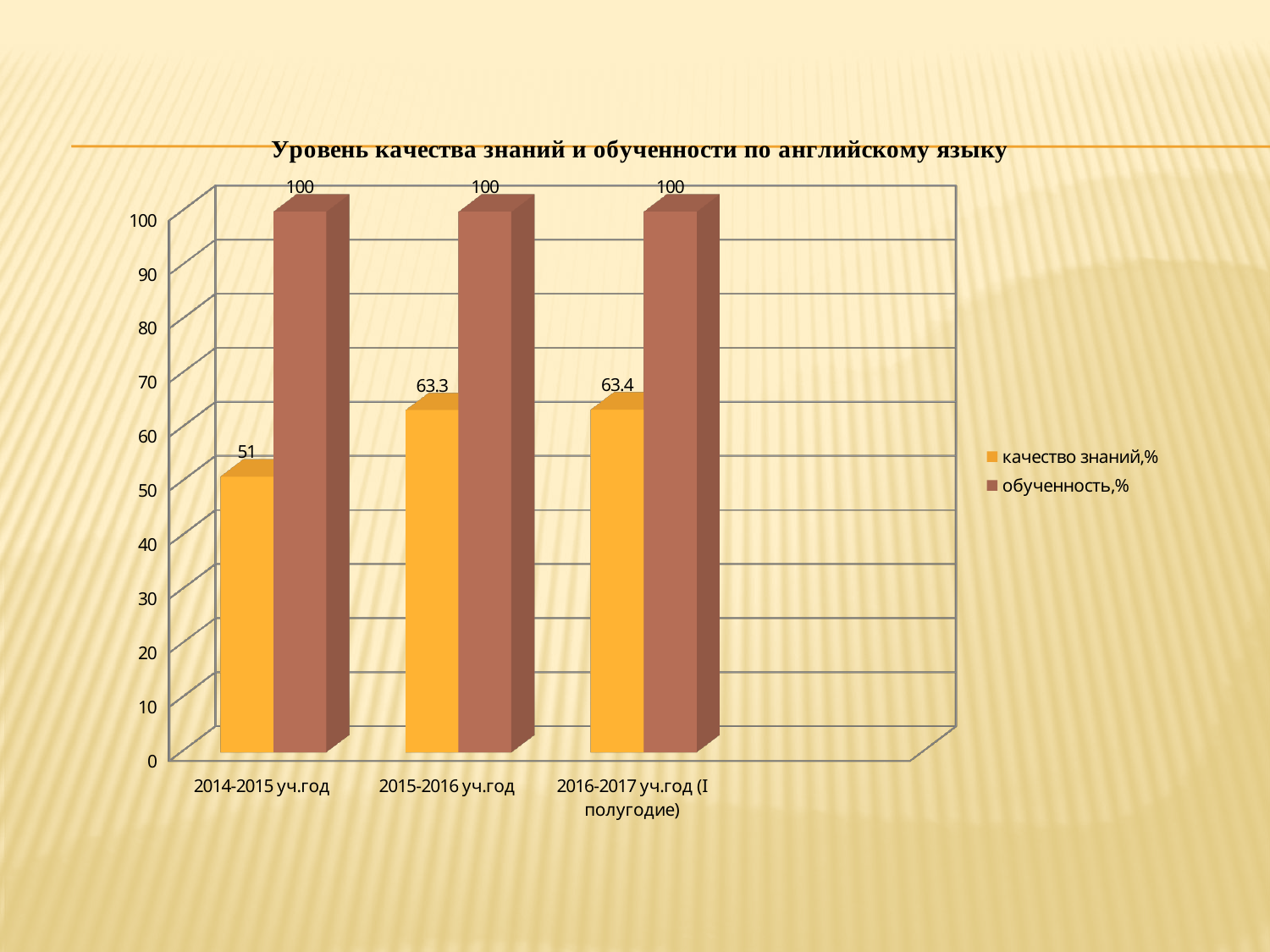
Does качество знаний,% rise or fall from 2014-2015 уч.год to 2016-2017 уч.год (I полугодие)? rise What is the difference in качество знаний,% between 2015-2016 уч.год and 2014-2015 уч.год? 12.3 What is the value of обученность,% for 2015-2016 уч.год? 100 What is the difference between обученность,% and качество знаний,% for 2014-2015 уч.год? 49 How many series does the legend list? 2 What is the value of качество знаний,% for 2016-2017 уч.год (I полугодие)? 63.4 How many academic years are shown on the x axis? 3 What is the value of качество знаний,% for 2015-2016 уч.год? 63.3 What kind of chart is shown on the slide? bar chart Which is larger: качество знаний,% for 2015-2016 уч.год or for 2014-2015 уч.год? 2015-2016 уч.год Which academic year has the lowest value for качество знаний,%? 2014-2015 уч.год What is the value of качество знаний,% for 2014-2015 уч.год? 51